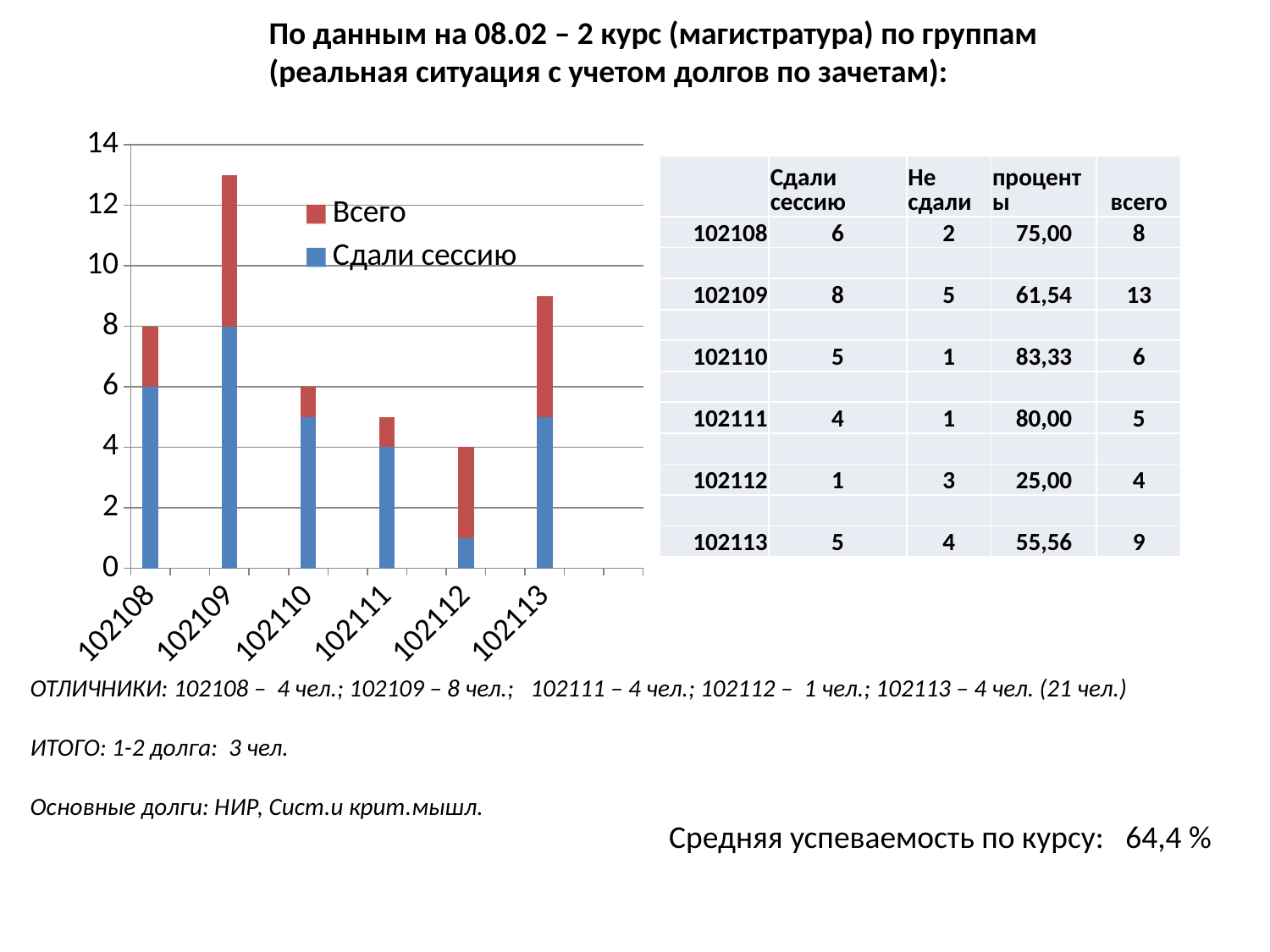
How many series does the chart legend list? 2 What is the difference between the total bar heights of groups 102109 and 102108? 5 What is the total height of the bar for group 102109? 13 Which is taller: the bar for group 102110 or the bar for group 102111? 102110 Which group has the tallest bar in the chart? 102109 How many groups are shown on the x axis of the chart? 6 What is the value of the 'Сдали сессию' segment for group 102112? 1 Which group has the shortest bar in the chart? 102112 What kind of chart is shown on the slide? bar chart What is the value of the 'Сдали сессию' segment for group 102108? 6 Is the total bar height for group 102113 greater or less than 8? greater Which colour represents the 'Сдали сессию' series in the chart? blue